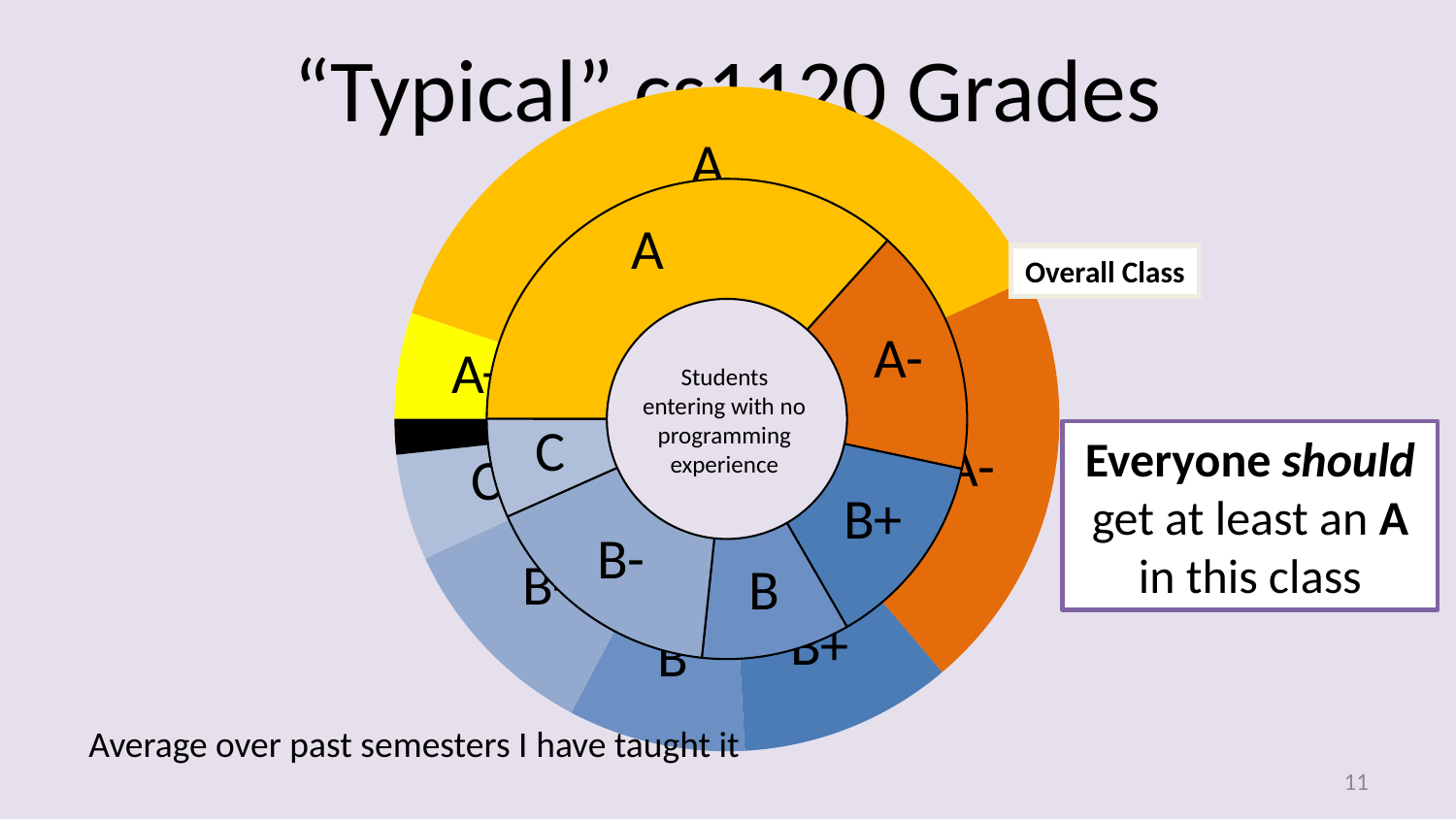
What kind of chart is shown on the slide? doughnut chart In the outer ring (Overall Class), which slice is larger: A or B? A Which grade has the largest slice in the inner ring (students entering with no programming experience)? A How many labeled grade categories are in the inner ring of the chart? 6 Which grade has the largest slice in the outer ring (Overall Class)? A In the inner ring, which slice is larger: A or C? A What does the outer ring of the chart represent? Overall Class In the inner ring, which slice is larger: A or B+? A What group of students does the inner ring of the chart represent? Students entering with no programming experience